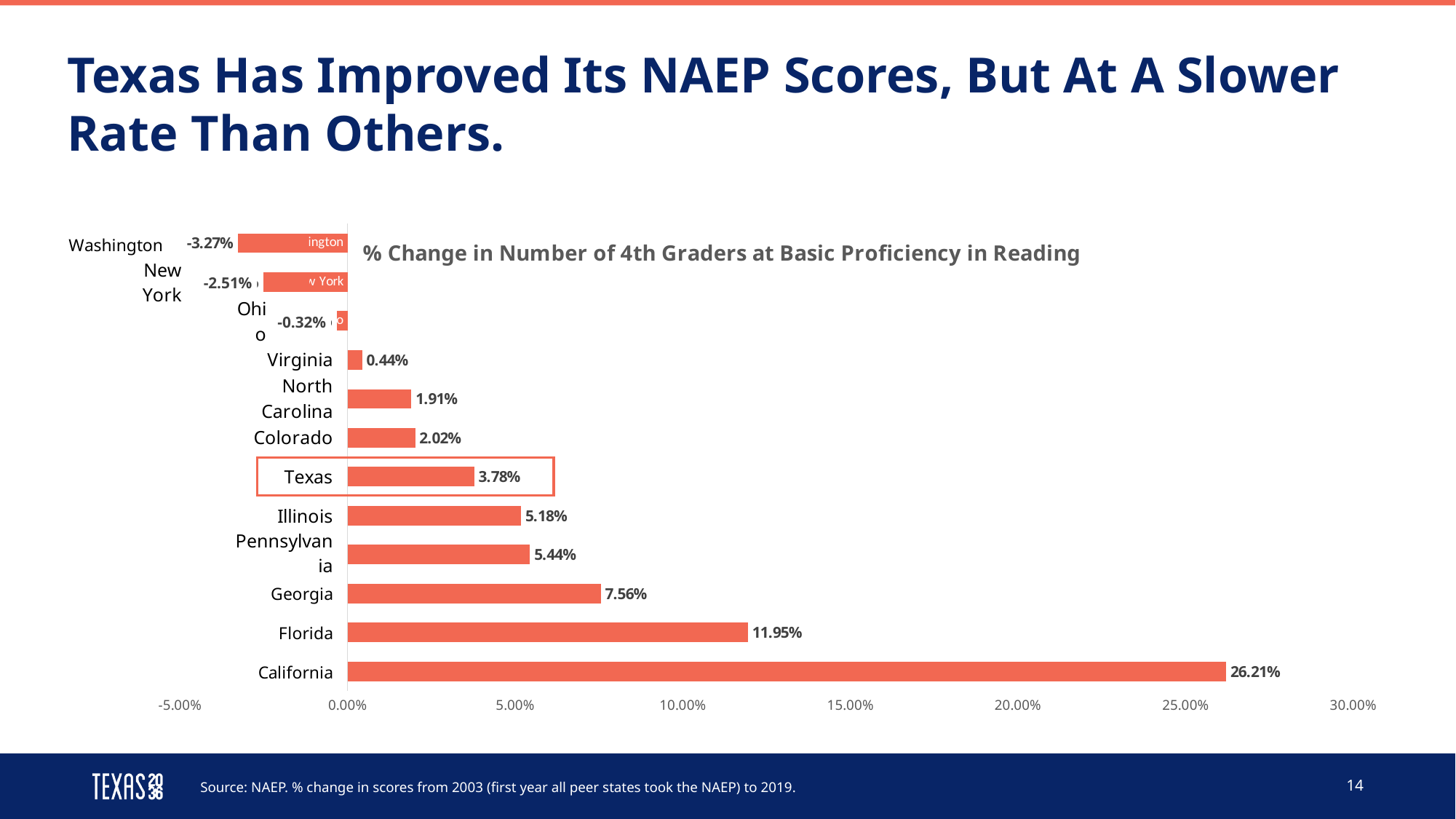
What kind of chart is shown on the slide? Bar chart What is the difference between the values for Florida and Georgia? 4.39% What is the title of the chart? % Change in Number of 4th Graders at Basic Proficiency in Reading What is the value for Texas? 3.78% What is the value for Washington? -3.27% What is the value for Florida? 11.95% Which state has the highest value? California How many states are shown in the chart? 12 What is the difference between the values for California and Texas? 22.43% Which state has the lowest value? Washington What is the value for California? 26.21% Which is larger, the value for Illinois or the value for Pennsylvania? Pennsylvania